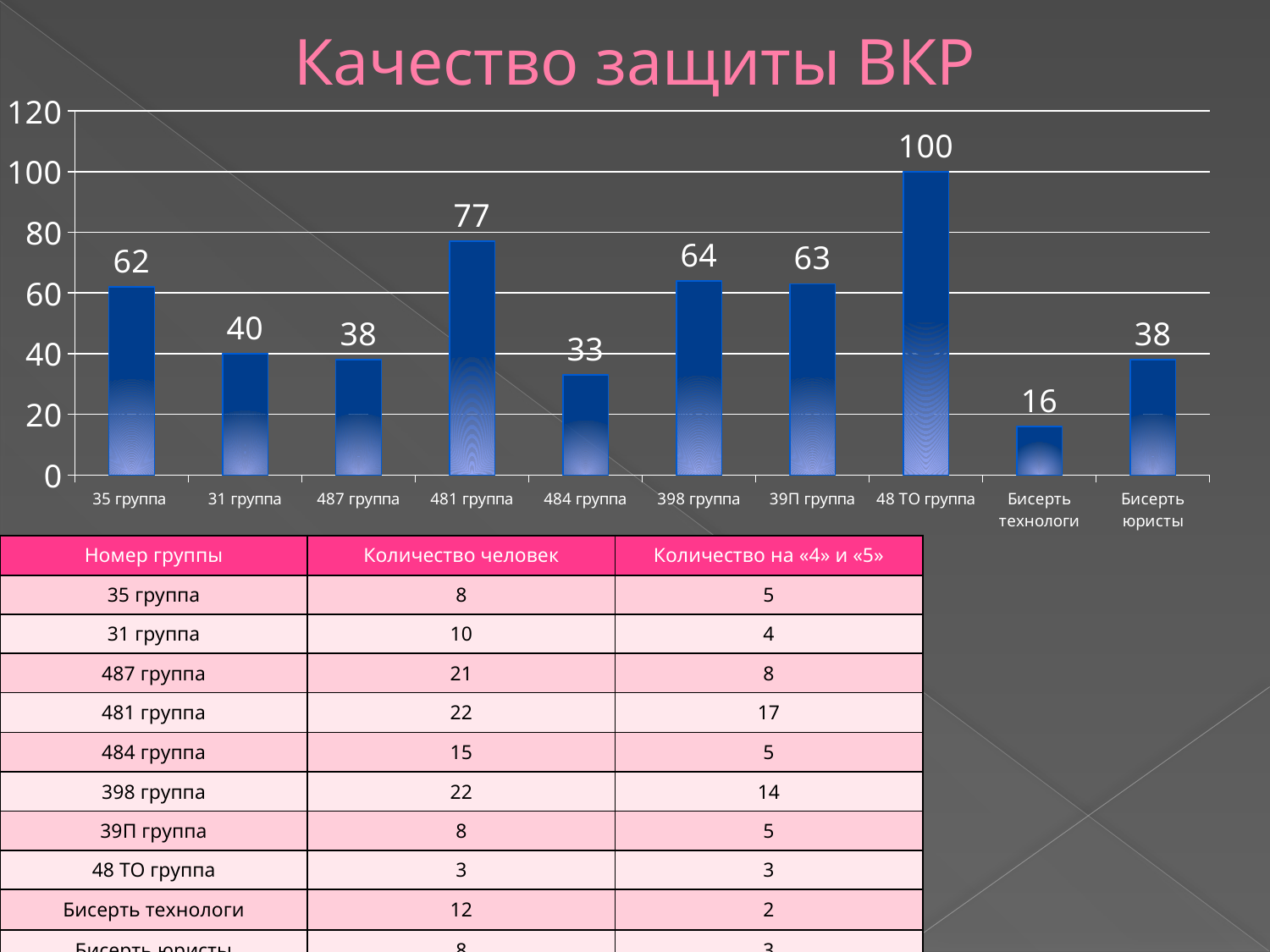
Which is larger, the value for 35 группа or the value for 31 группа? 35 группа Is the value for 484 группа greater or less than 40? less What is the value for 481 группа? 77 What is the difference between the values for 35 группа and 487 группа? 24 What is the title of the chart? Качество защиты ВКР Which category has the lowest value? Бисерть технологи What is the difference between the values for 48 ТО группа and 481 группа? 23 How many categories are shown on the x axis? 10 What kind of chart is shown on the slide? bar chart Which category has the highest value? 48 ТО группа What is the value for Бисерть технологи? 16 What is the value for 398 группа? 64